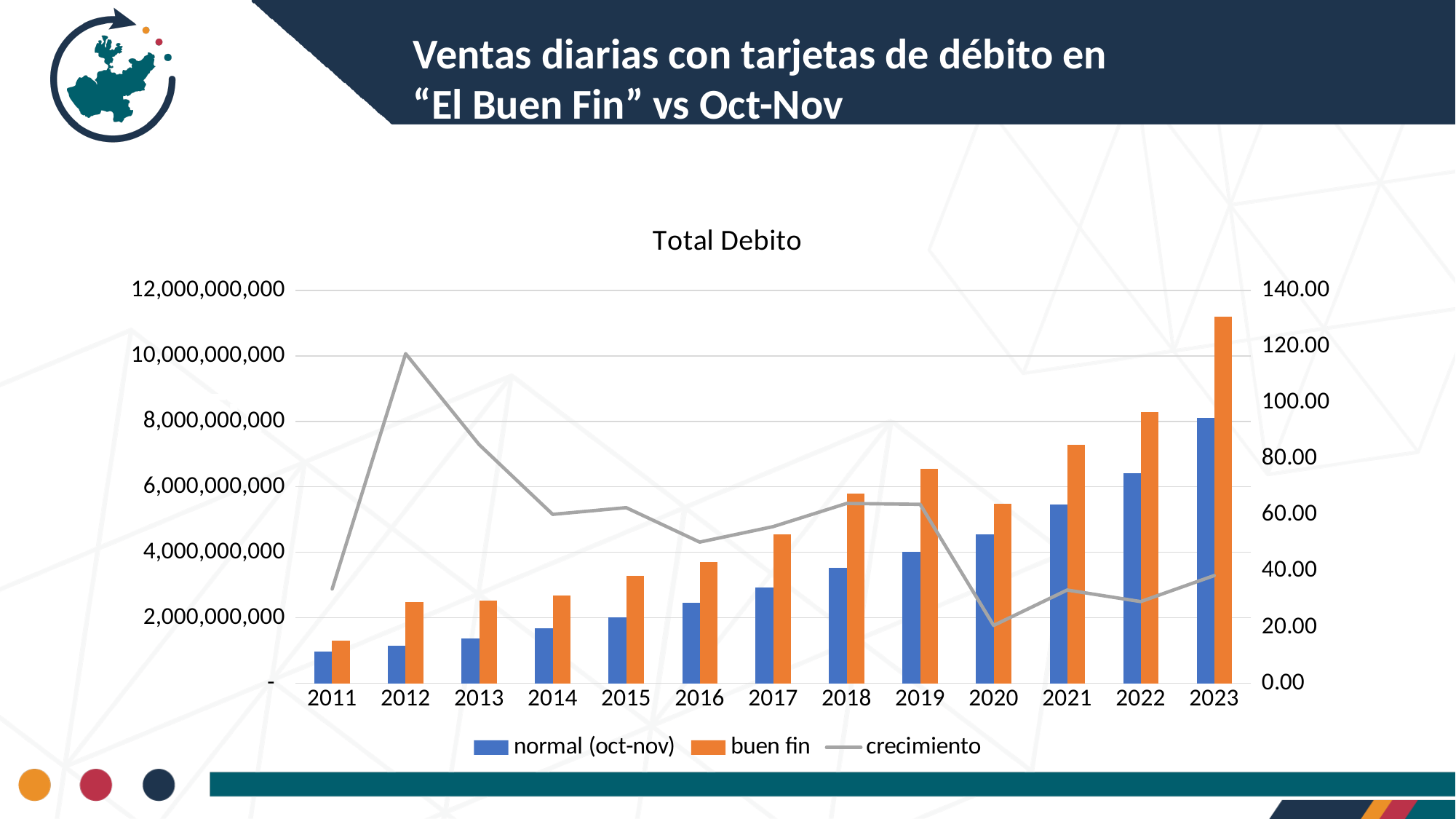
In which year is the 'normal (oct-nov)' bar the lowest? 2011 Do the 'normal (oct-nov)' bars generally rise or fall from 2011 to 2023? rise Which series is drawn as a grey line in the chart? crecimiento In which year does the 'crecimiento' line reach its highest point? 2012 In which year does the 'crecimiento' line reach its lowest point? 2020 What kind of chart is shown on the slide? A combined bar and line chart In which year is the 'buen fin' bar the highest? 2023 How many years are shown along the x axis of the chart? 13 Is the value of the 'buen fin' bar for 2023 greater or less than 10,000,000,000? greater What is the title of the chart? Total Debito In 2023, which is larger: the 'buen fin' bar or the 'normal (oct-nov)' bar? buen fin How many series does the chart's legend list? 3